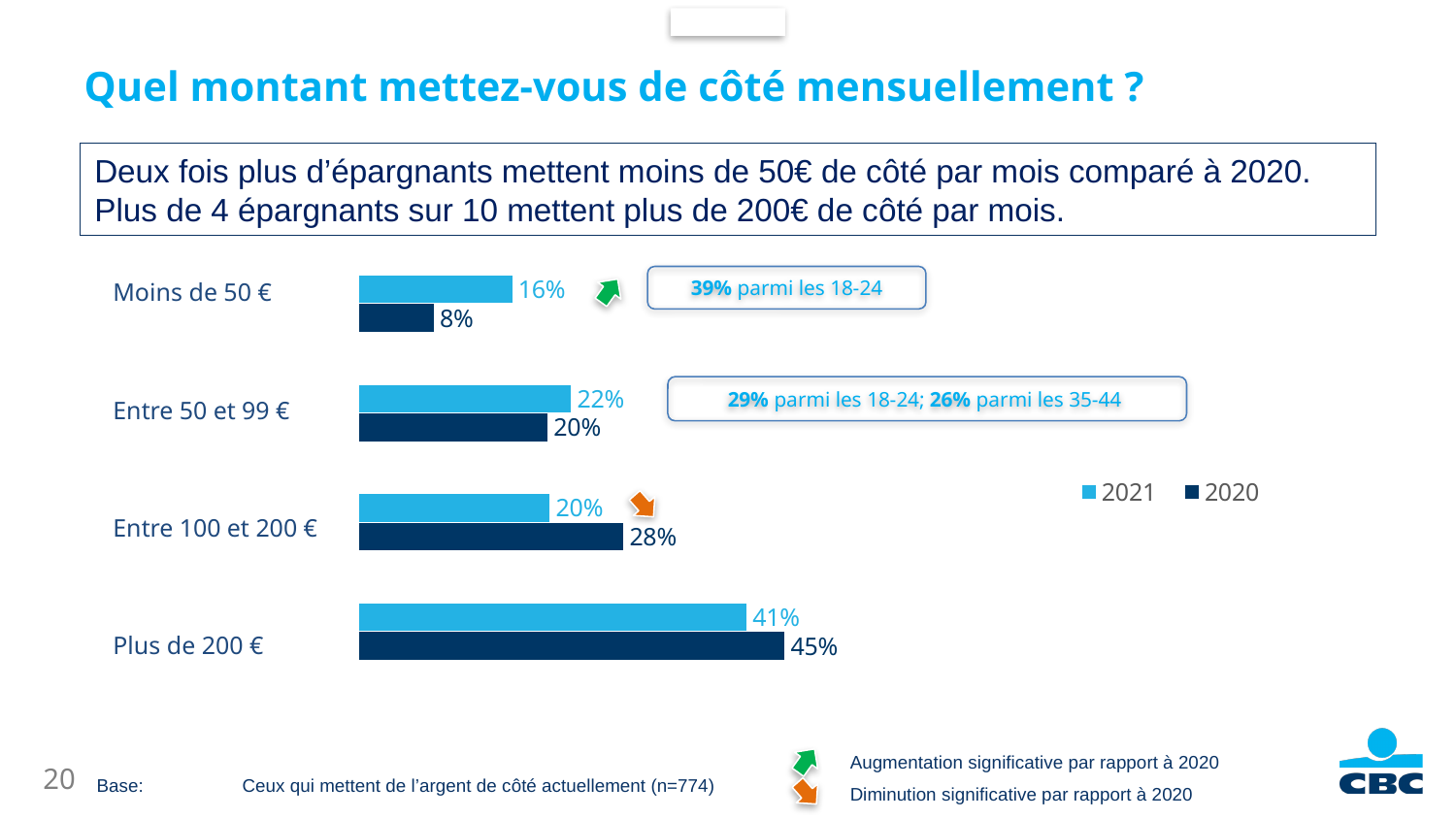
What kind of chart is shown on the slide? Bar chart Which category has the highest 2020 value? Plus de 200 € Which category has the lowest 2021 value? Moins de 50 € What is the difference between the 2021 and 2020 values for 'Moins de 50 €'? 8% What is the 2021 value for 'Moins de 50 €'? 16% What is the difference between the 2020 and 2021 values for 'Entre 100 et 200 €'? 8% What is the 2021 value for 'Plus de 200 €'? 41% Which series does the legend show in dark blue? 2020 How many series does the legend list? 2 What is the 2020 value for 'Entre 100 et 200 €'? 28% Which is larger for 'Entre 50 et 99 €': the 2021 value or the 2020 value? 2021 How many categories are shown in the chart? 4